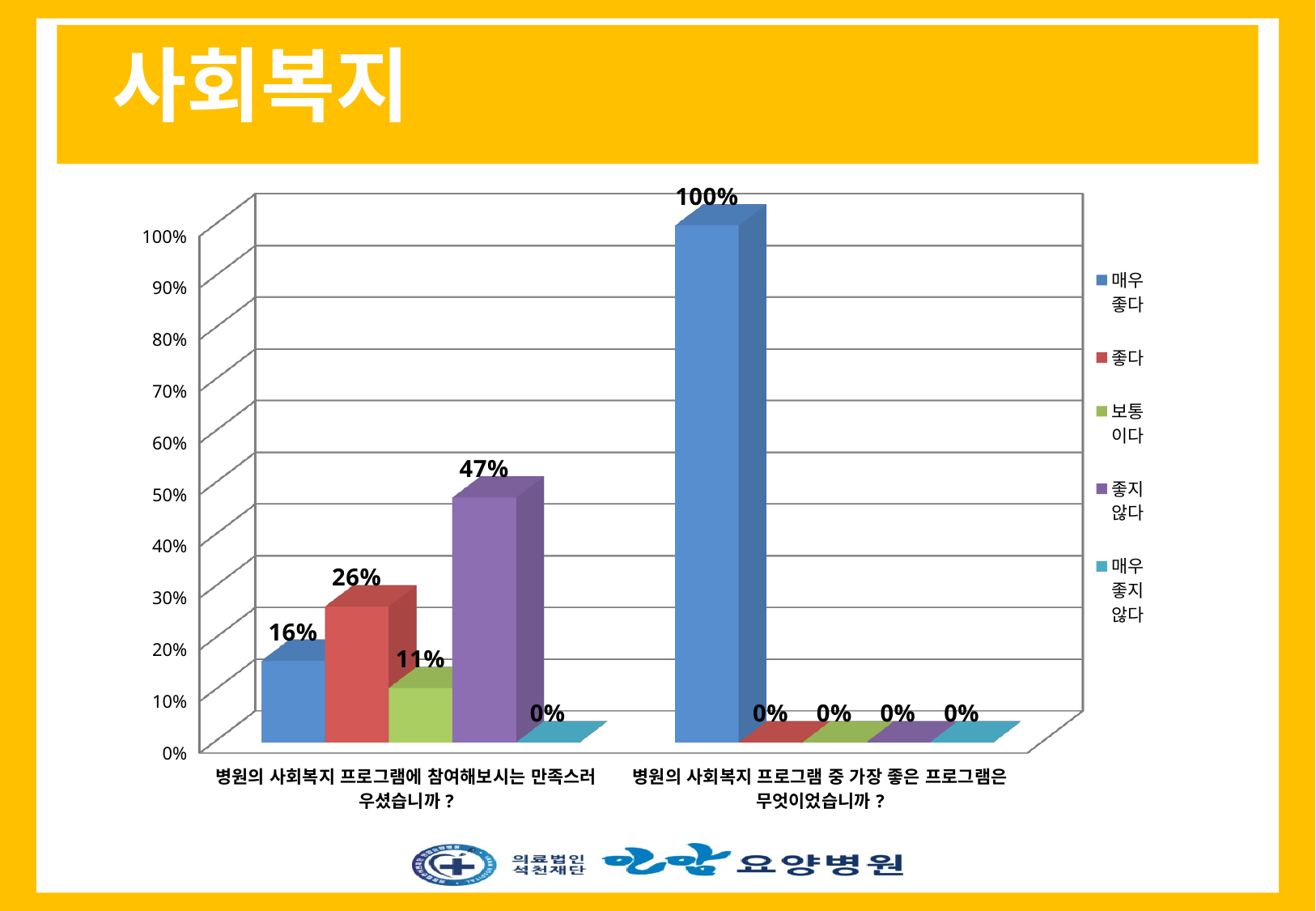
How many series does the legend list? 5 What colour are the bars for the 매우 좋다 series? blue Which series has the lowest value in the category '병원의 사회복지 프로그램에 참여해보시는 만족스러우셨습니까 ?'? 매우 좋지 않다 How many categories are shown on the x axis? 2 In the category '병원의 사회복지 프로그램에 참여해보시는 만족스러우셨습니까 ?', which is larger, the value for 좋다 or the value for 매우 좋다? 좋다 What is the value for 좋지 않다 in the category '병원의 사회복지 프로그램에 참여해보시는 만족스러우셨습니까 ?'? 47% Which series has the highest value in the category '병원의 사회복지 프로그램에 참여해보시는 만족스러우셨습니까 ?'? 좋지 않다 What is the value for 매우 좋다 in the category '병원의 사회복지 프로그램 중 가장 좋은 프로그램은 무엇이었습니까 ?'? 100% What kind of chart is shown on the slide? bar chart What is the difference between the 좋지 않다 value and the 매우 좋다 value in the category '병원의 사회복지 프로그램에 참여해보시는 만족스러우셨습니까 ?'? 31% What is the value for 좋다 in the category '병원의 사회복지 프로그램에 참여해보시는 만족스러우셨습니까 ?'? 26% What is the value for 보통이다 in the category '병원의 사회복지 프로그램에 참여해보시는 만족스러우셨습니까 ?'? 11%